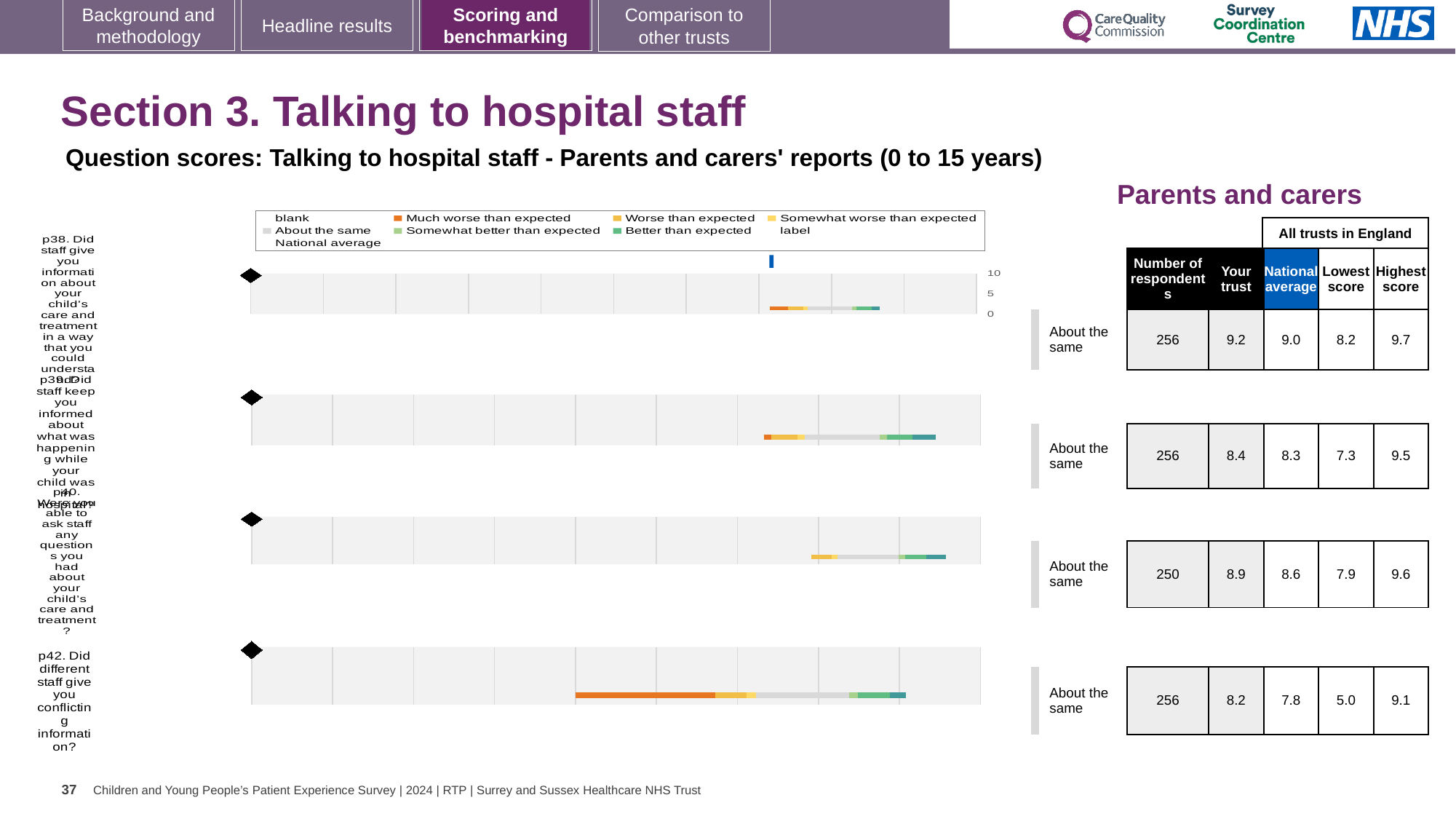
Which question has the lowest 'Your trust' score on this slide? p42 Which question has the highest 'Your trust' score on this slide? p38 What is the National average score for p42 (Did different staff give you conflicting information)? 7.8 In the chart legend, which colour represents 'Much worse than expected'? Orange What benchmarking category is shown for p39 (Did staff keep you informed about what was happening while your child was in hospital)? About the same How many survey questions (p38 to p42) have a benchmarking bar plotted on this slide? 4 What is the Lowest score across all trusts in England for p42? 5.0 For p40, which is larger: the 'Your trust' score or the National average? Your trust What is the 'Your trust' score for p38 (Did staff give you information about your child's care and treatment in a way that you could understand)? 9.2 How many respondents answered p40 (Were you able to ask staff any questions you had about your child's care and treatment)? 250 For p38, what is the difference between the Highest score and the Lowest score across all trusts in England? 1.5 What kind of chart is used to show the benchmarking results for each question on this slide? Bar chart